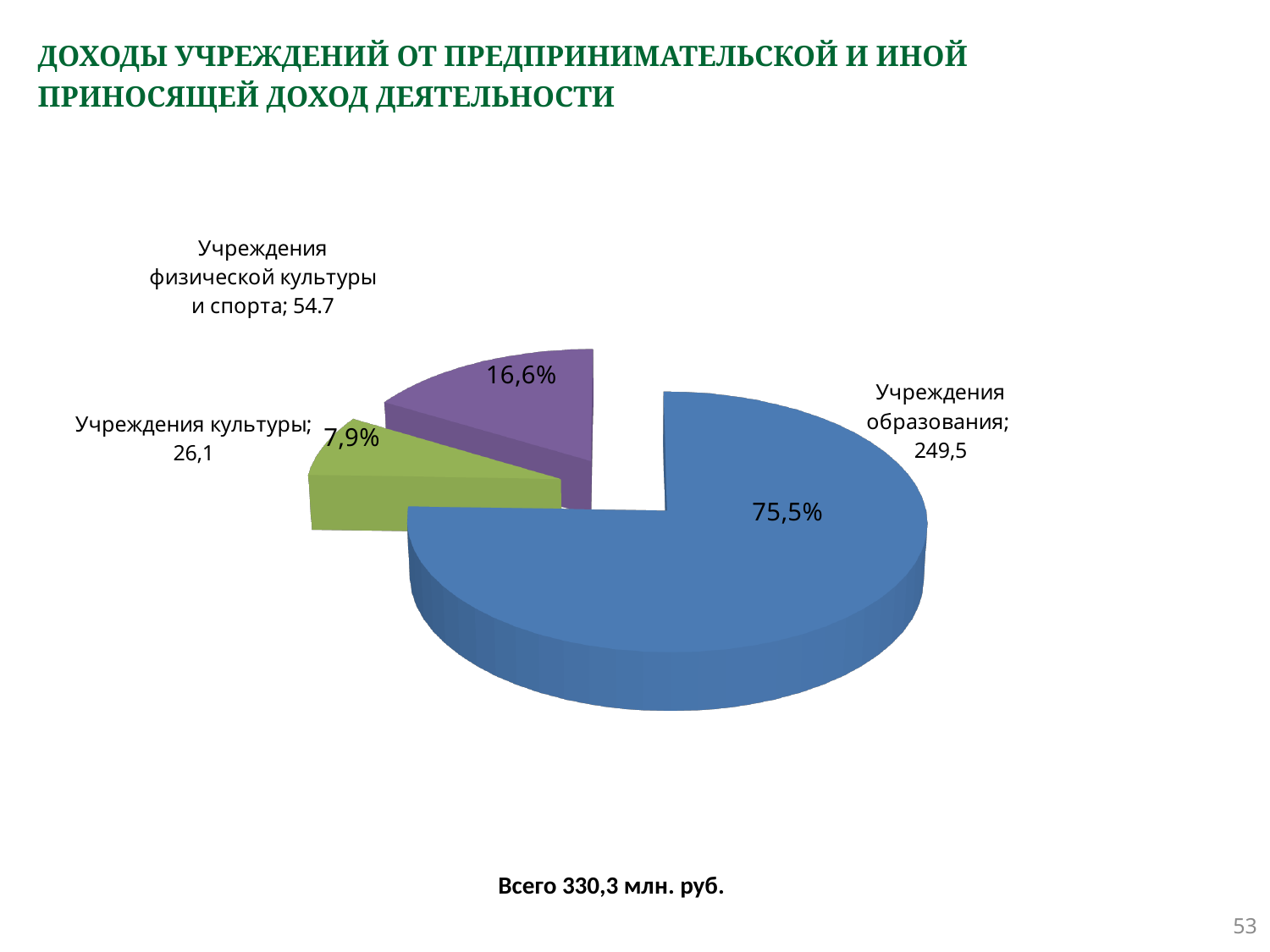
What share of the pie does Учреждения физической культуры и спорта represent? 16,6% What is the value for Учреждения образования? 249,5 What share of the pie does Учреждения образования represent? 75,5% What kind of chart is shown on the slide? pie chart What is the value for Учреждения культуры? 26,1 How many slices does the pie chart have? 3 What share of the pie does Учреждения культуры represent? 7,9% Which category has the largest slice of the pie? Учреждения образования What is the difference between the value for Учреждения образования and the value for Учреждения культуры? 223,4 What is the value for Учреждения физической культуры и спорта? 54.7 Which is larger, the value for Учреждения физической культуры и спорта or the value for Учреждения культуры? Учреждения физической культуры и спорта Which category has the smallest slice of the pie? Учреждения культуры